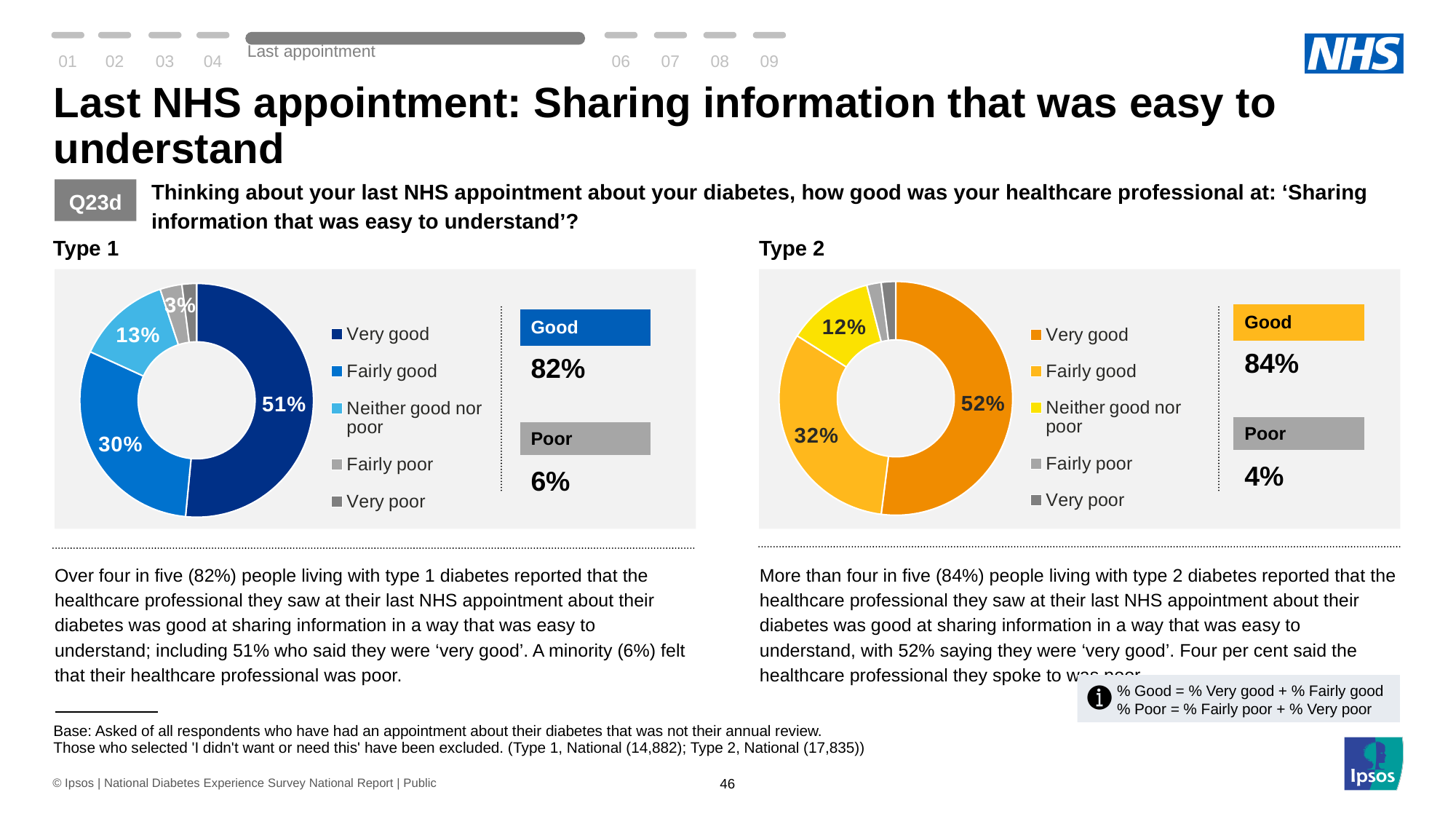
How many response categories does the legend of the Type 1 chart list? 5 In the Type 2 chart, which is larger, 'Very good' or 'Fairly good'? Very good In the Type 1 chart, which response category has the largest share? Very good What colour represents 'Very good' in the Type 2 chart? Orange In the Type 2 chart, what percentage of respondents said 'Fairly good'? 32% What type of chart is used for Type 1 and Type 2? Donut (pie) chart What is the combined 'Poor' percentage shown next to the Type 1 chart? 6% In the Type 1 chart, what percentage of respondents said 'Very good'? 51% In the Type 1 chart, what percentage of respondents said 'Neither good nor poor'? 13% In the Type 1 chart, what is the difference between the 'Very good' and 'Fairly good' shares? 21 percentage points What is the combined 'Good' percentage shown next to the Type 2 chart? 84% In the Type 2 chart, what percentage of respondents said 'Neither good nor poor'? 12%